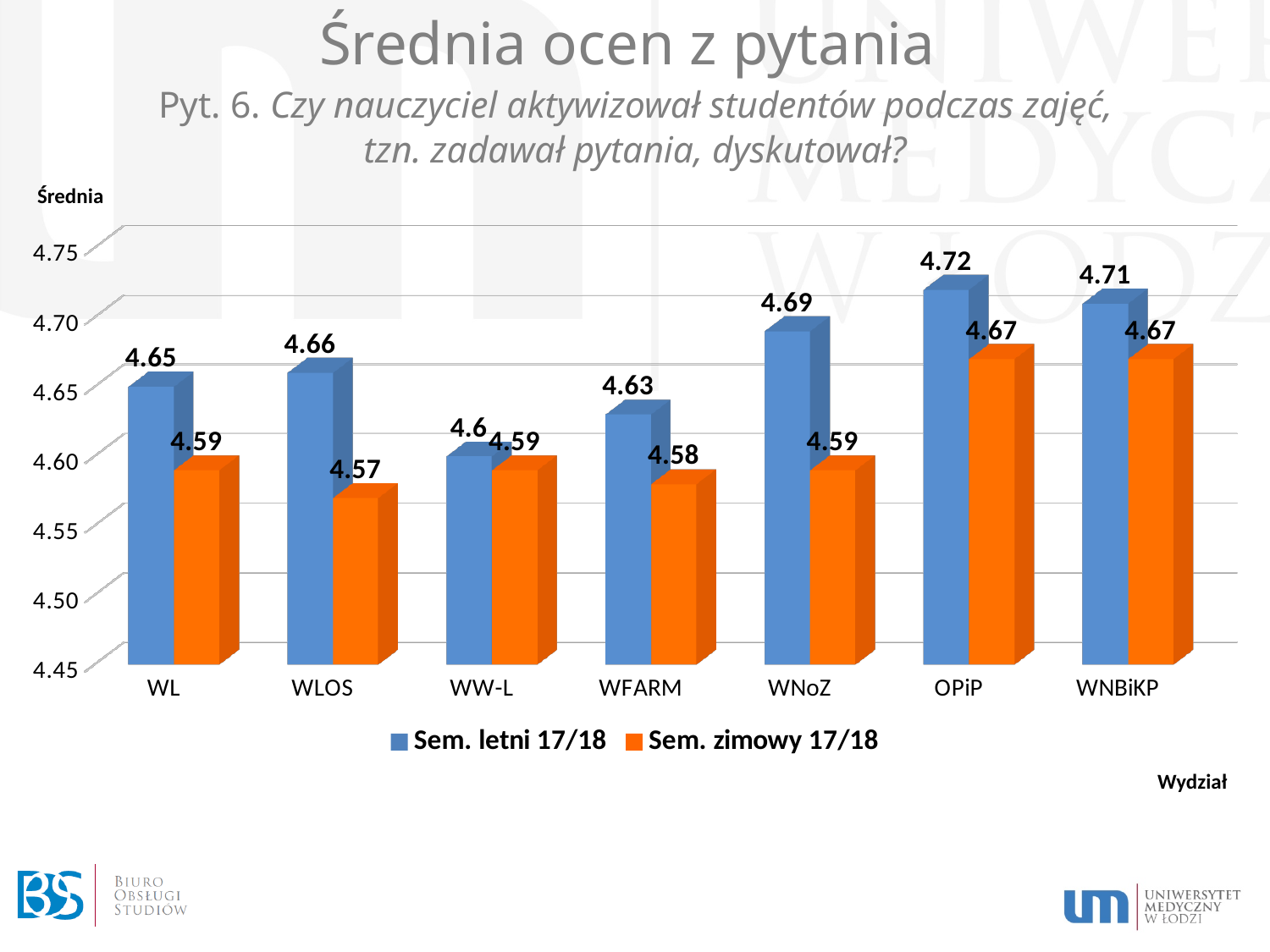
Which is larger for WFARM: the Sem. letni 17/18 value or the Sem. zimowy 17/18 value? Sem. letni 17/18 What kind of chart is shown on the slide? bar chart What is the difference between the Sem. letni 17/18 and Sem. zimowy 17/18 values for WNoZ? 0.1 What is the value for WLOS in the Sem. zimowy 17/18 series? 4.57 How many series does the legend list? 2 Which colour represents the Sem. zimowy 17/18 series? orange How many categories are shown on the x axis? 7 What is the value for OPiP in the Sem. letni 17/18 series? 4.72 What is the value for WW-L in the Sem. letni 17/18 series? 4.6 What is the value for WNBiKP in the Sem. zimowy 17/18 series? 4.67 Which category has the lowest value in the Sem. zimowy 17/18 series? WLOS Which category has the highest value in the Sem. letni 17/18 series? OPiP